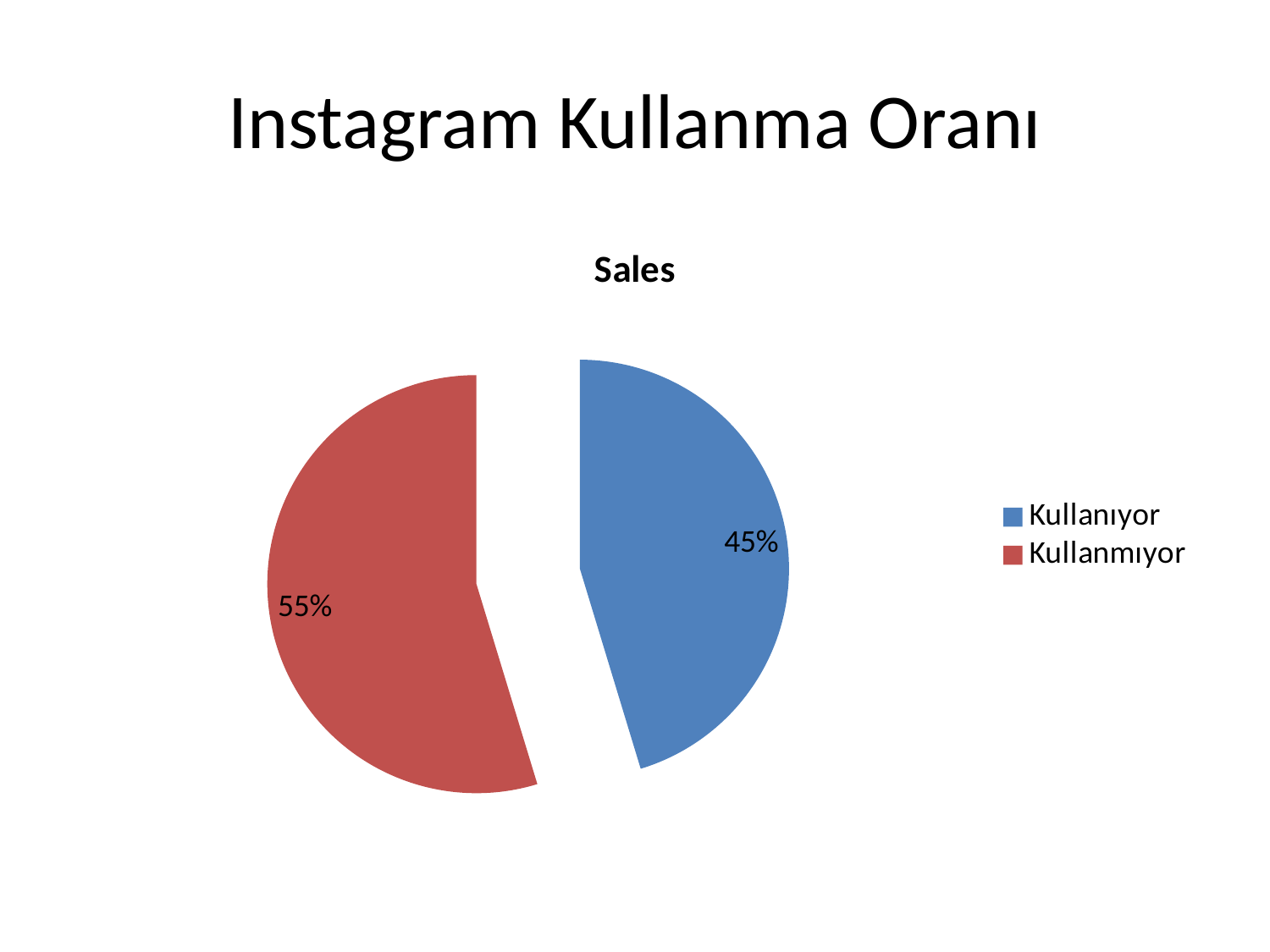
What is the difference in percentage points between the Kullanmıyor and Kullanıyor slices? 10% What kind of chart is shown on the slide? pie chart How many entries does the legend list? 2 What percentage of the pie does the Kullanıyor slice represent? 45% Which slice is the smallest? Kullanıyor What percentage of the pie does the Kullanmıyor slice represent? 55% Which is larger, the Kullanıyor slice or the Kullanmıyor slice? Kullanmıyor How many slices does the pie chart have? 2 What is the chart's title? Sales Which slice is the largest? Kullanmıyor What colour is the Kullanıyor slice? blue